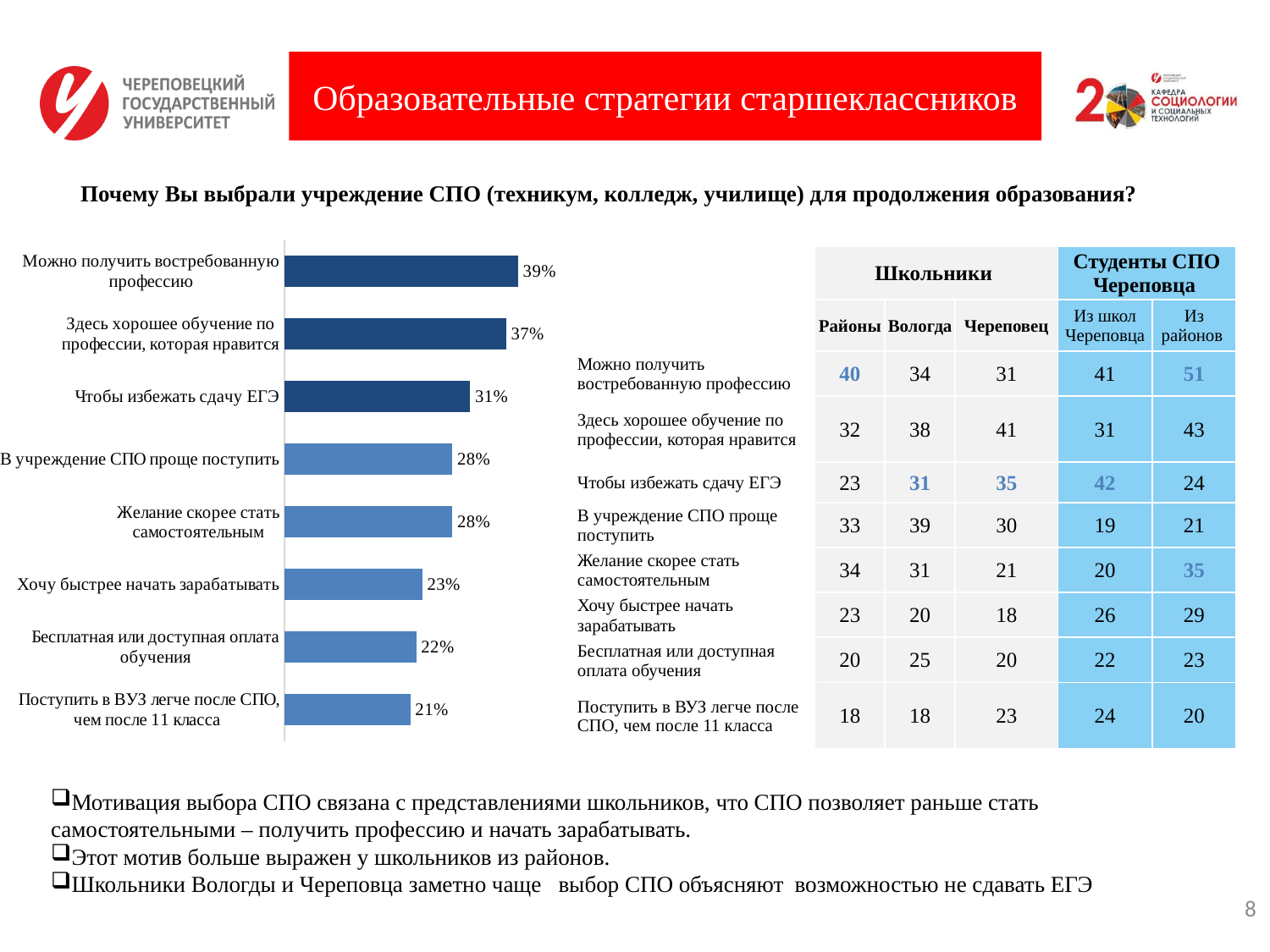
Which category has the highest value in the bar chart? Можно получить востребованную профессию What is the value for "Поступить в ВУЗ легче после СПО, чем после 11 класса" in the bar chart? 21% How many categories (reasons) are plotted in the bar chart? 8 Which is larger in the bar chart: "Здесь хорошее обучение по профессии, которая нравится" or "Чтобы избежать сдачу ЕГЭ"? Здесь хорошее обучение по профессии, которая нравится What is the value for "Хочу быстрее начать зарабатывать" in the bar chart? 23% What type of chart is shown on the slide? bar chart Which category has the lowest value in the bar chart? Поступить в ВУЗ легче после СПО, чем после 11 класса What is the value for "Можно получить востребованную профессию" in the bar chart? 39% What is the value for "Чтобы избежать сдачу ЕГЭ" in the bar chart? 31% What is the difference between "В учреждение СПО проще поступить" (28%) and "Бесплатная или доступная оплата обучения" (22%) in the bar chart? 6 percentage points What is the difference between the highest value (39%) and the lowest value (21%) in the bar chart? 18 percentage points How many bars in the chart are drawn in the darker blue colour? 3